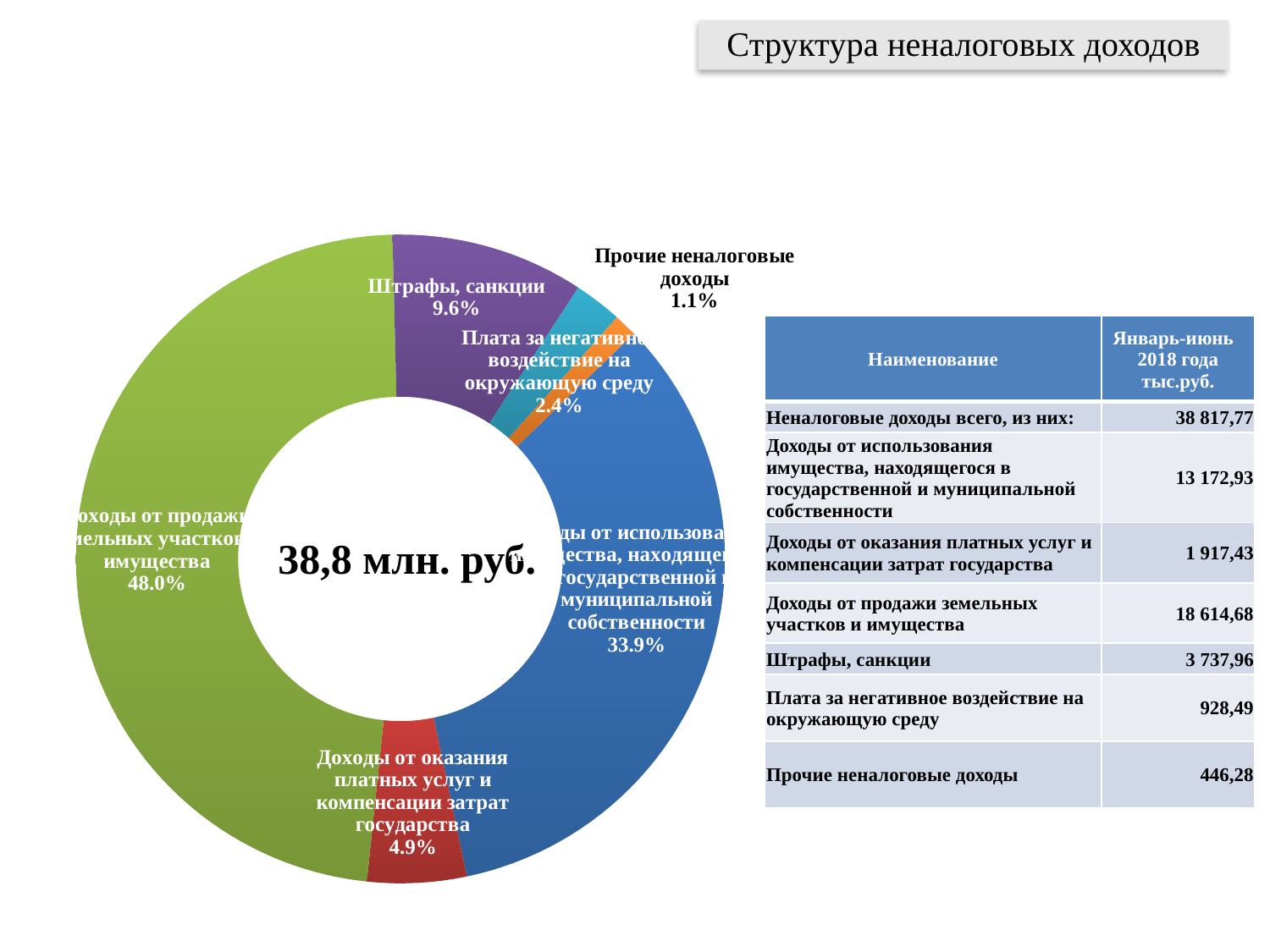
What percentage is shown for "Доходы от оказания платных услуг и компенсации затрат государства" on the chart? 4.9% Which is larger: the share for "Штрафы, санкции" or the share for "Доходы от оказания платных услуг и компенсации затрат государства"? Штрафы, санкции What percentage is shown for "Прочие неналоговые доходы" on the chart? 1.1% What share of the doughnut chart is labelled for "Штрафы, санкции"? 9.6% What colour is the slice for "Штрафы, санкции" in the chart? Purple What is the difference in percentage points between the share for "Доходы от продажи земельных участков и имущества" (48.0%) and the share for "Доходы от использования имущества" (33.9%)? 14.1 percentage points Which category has the smallest share in the chart? Прочие неналоговые доходы What total value is printed in the centre of the doughnut chart? 38,8 млн. руб. What percentage is shown for "Плата за негативное воздействие на окружающую среду" on the chart? 2.4% How many slices does the doughnut chart have? 6 What kind of chart is shown on the slide? Doughnut (pie) chart Which category has the largest share in the chart? Доходы от продажи земельных участков и имущества